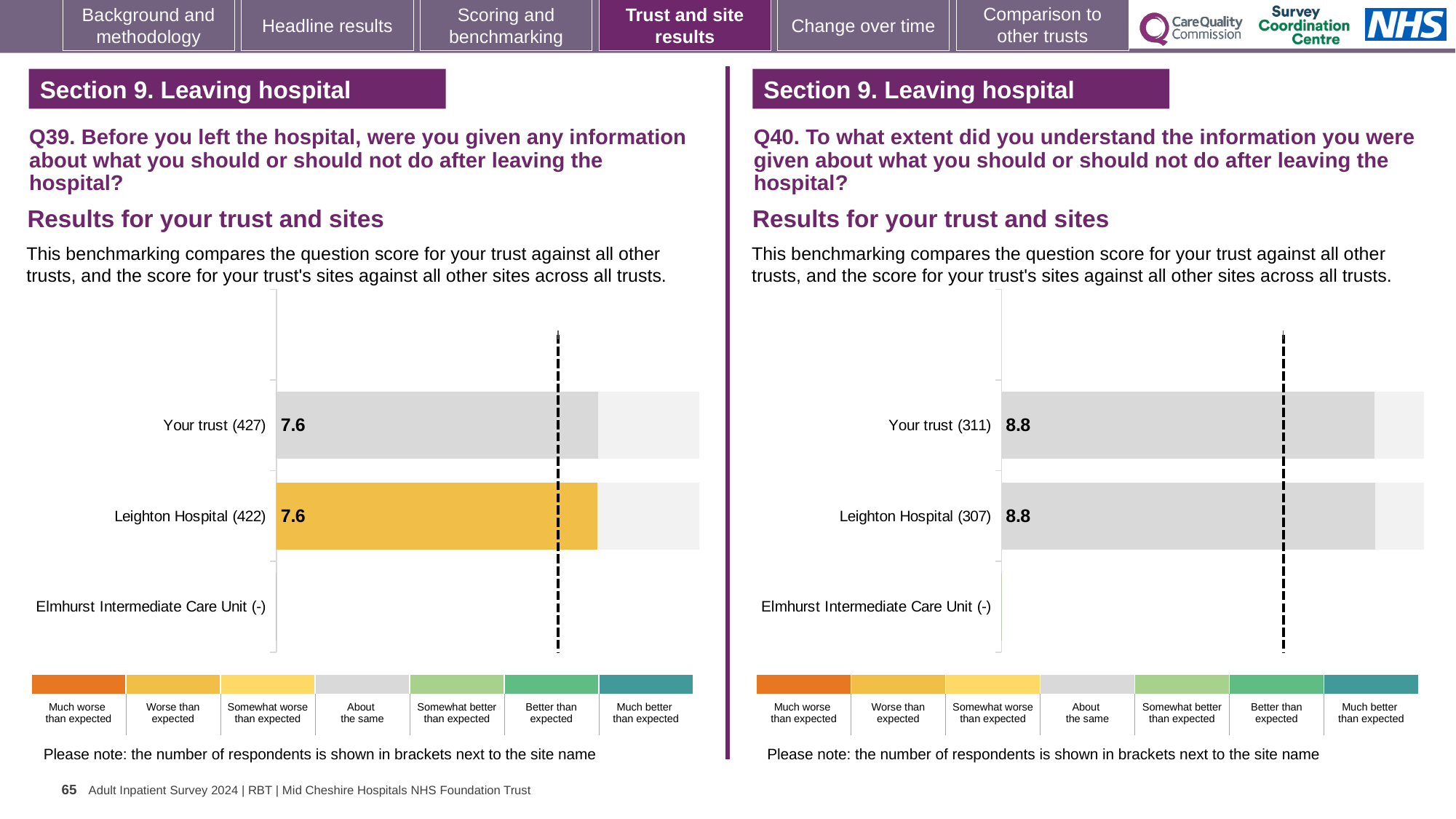
In the Q39 chart on the left, how many respondents are shown in brackets for Your trust? 427 In the Q40 chart on the right, how many respondents are shown in brackets for Leighton Hospital? 307 In the Q40 chart on the right, what is the difference between the scores for Your trust and Leighton Hospital? 0.0 How many site/trust categories are listed on the y axis of the Q39 chart on the left? 3 In the Q39 chart on the left, what is the score for Your trust? 7.6 In the Q39 chart on the left, which category has no score shown? Elmhurst Intermediate Care Unit What kind of chart is used in the Q40 chart on the right? Bar chart In the Q40 chart on the right, what is the score for Leighton Hospital? 8.8 In the Q39 chart on the left, what is the score for Leighton Hospital? 7.6 In the Q39 chart on the left, what colour is the bar for Leighton Hospital? Orange/yellow In the Q39 chart on the left, what is the difference between the scores for Your trust and Leighton Hospital? 0.0 In the Q40 chart on the right, what is the score for Your trust? 8.8